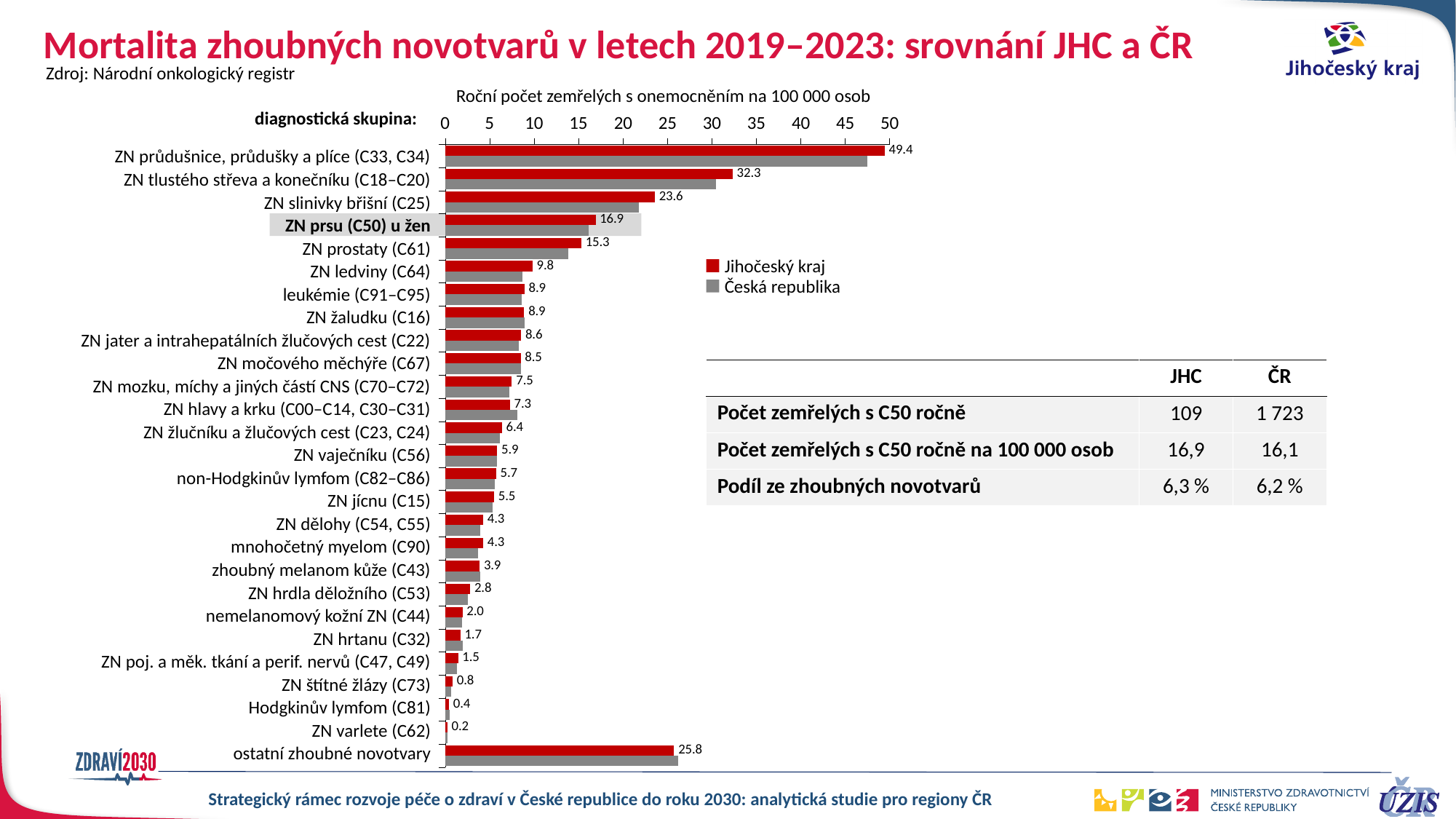
How many series does the legend list? 2 What kind of chart is shown on the slide? bar chart What is the value for Jihočeský kraj for ostatní zhoubné novotvary? 25.8 What is the value for Jihočeský kraj for ZN prsu (C50) u žen? 16.9 Which has the larger Jihočeský kraj value: ZN slinivky břišní (C25) or ZN prostaty (C61)? ZN slinivky břišní (C25) How many diagnostic groups are shown in the chart? 27 Which diagnostic group has the lowest Jihočeský kraj value? ZN varlete (C62) What is the value for Jihočeský kraj for ZN průdušnice, průdušky a plíce (C33, C34)? 49.4 What is the difference between the Jihočeský kraj values for ZN průdušnice, průdušky a plíce (C33, C34) and ZN tlustého střeva a konečníku (C18–C20)? 17.1 Which diagnostic group has the highest Jihočeský kraj value? ZN průdušnice, průdušky a plíce (C33, C34) Is the Česká republika value for ZN průdušnice, průdušky a plíce (C33, C34) greater or less than 45? greater Is the Česká republika value for ZN slinivky břišní (C25) greater or less than 25? less